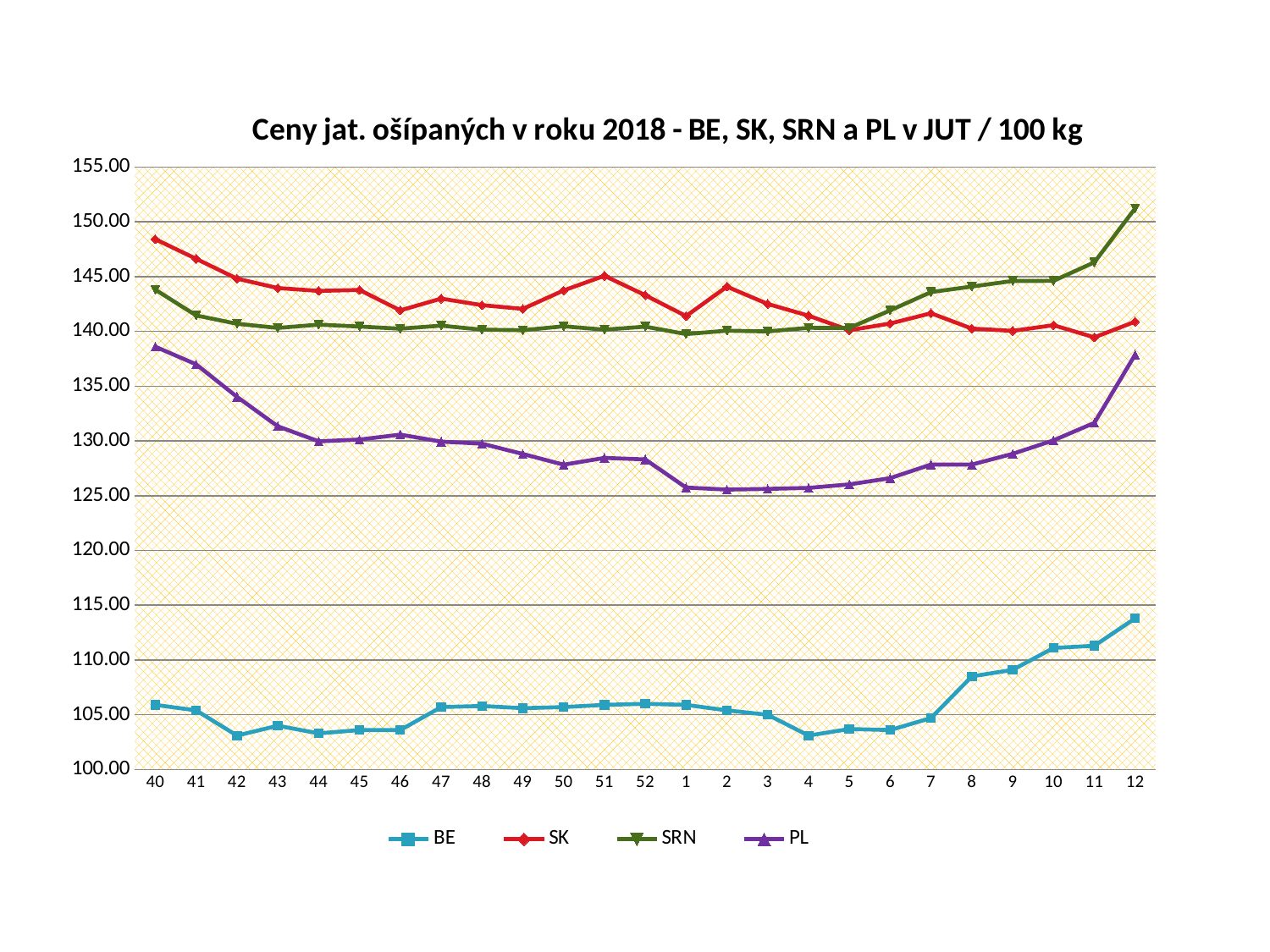
How many series does the legend list? 4 What kind of chart is shown on the slide? line chart Is the value for SK at week 40 greater or less than 145.00? greater What is the title of the chart? Ceny jat. ošípaných v roku 2018 - BE, SK, SRN a PL v JUT / 100 kg Is the value for BE at week 12 greater or less than 110.00? greater Which series has the lowest values across the whole chart? BE Does the BE line rise or fall from week 7 to week 12? rises At week 40, which series has the higher value, SK or SRN? SK At week 12, which series has the higher value, SRN or SK? SRN How many points (weeks) are shown along the x axis? 25 Is the value for SRN at week 12 greater or less than 150.00? greater